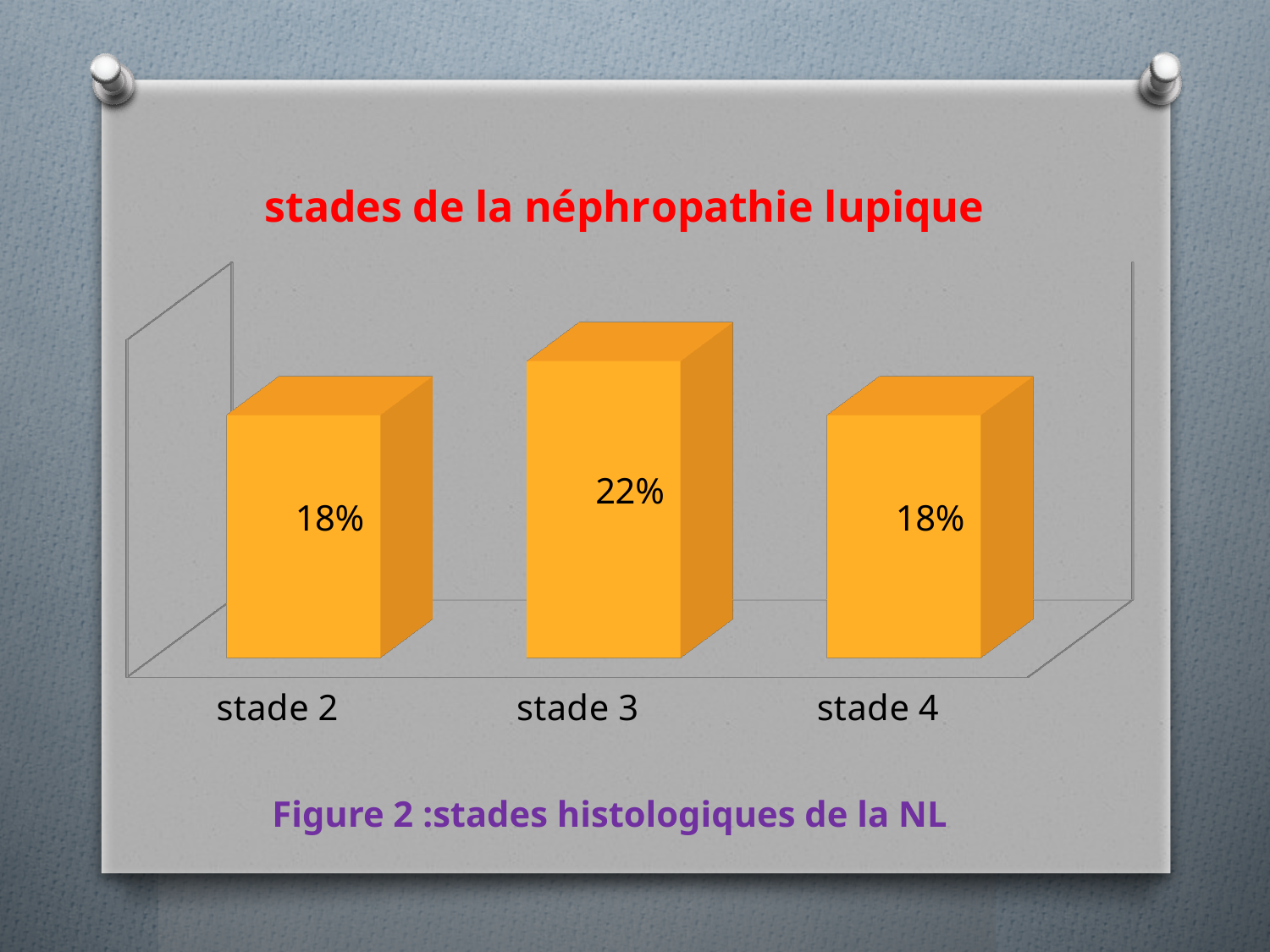
What is the difference between the values for stade 3 and stade 2? 4% What is the value for stade 3? 22% What colour are the bars in the chart? orange Do stade 2 and stade 4 have the same value? yes Which stage has the highest value? stade 3 What kind of chart is shown on the slide? bar chart What is the value for stade 4? 18% What is the value for stade 2? 18% How many stages are shown on the chart? 3 What is the title of the chart? stades de la néphropathie lupique Which is larger, the value for stade 3 or the value for stade 4? stade 3